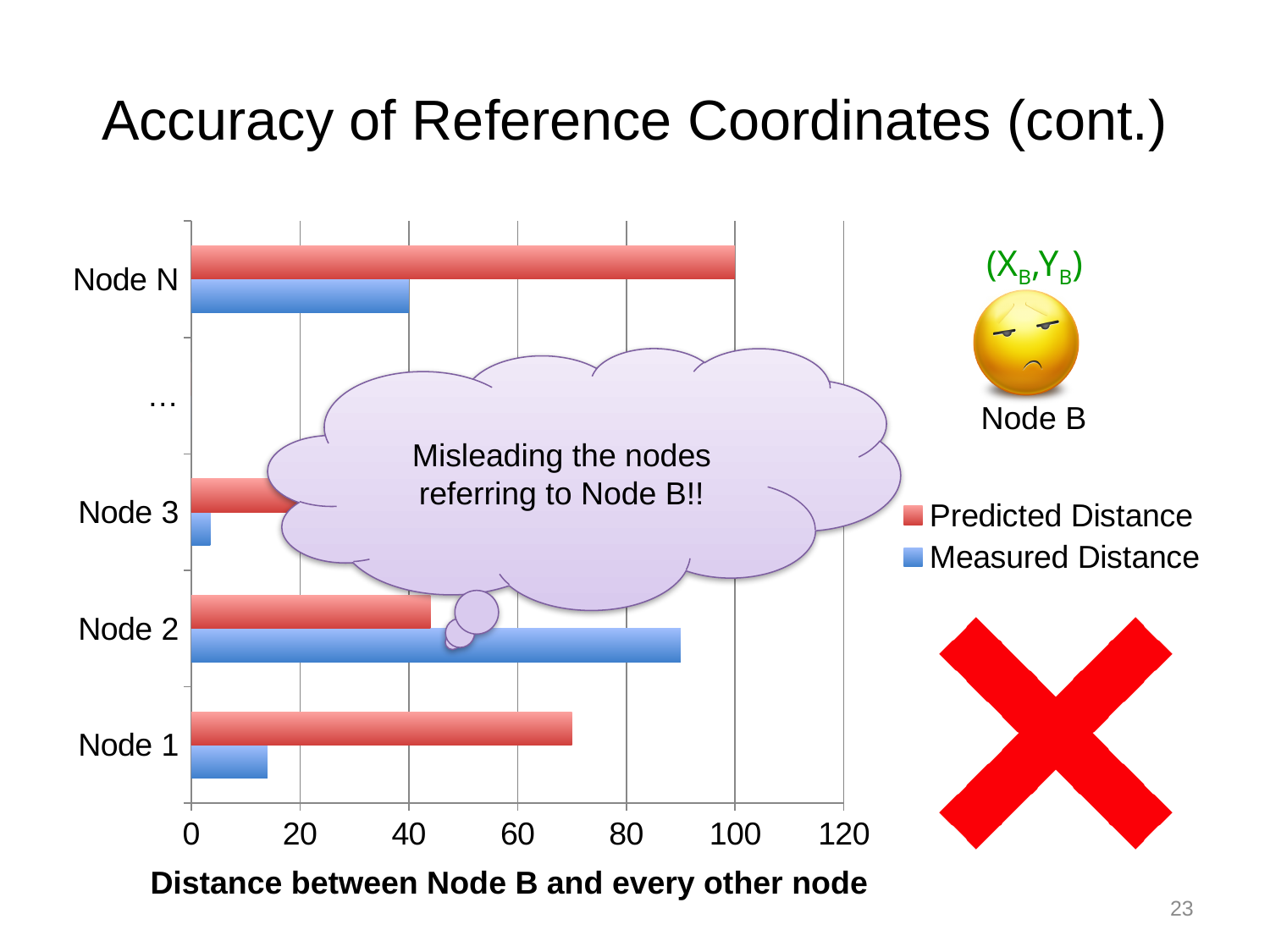
Is the Predicted Distance for Node 1 greater or less than 60? greater What is the title of the horizontal axis of the chart? Distance between Node B and every other node Which node has the lowest Measured Distance? Node 3 How many series does the chart legend list? 2 Is the Measured Distance for Node 1 greater or less than 20? less For Node 2, which is larger: the Predicted Distance or the Measured Distance? Measured Distance What is the Measured Distance for Node N? 40 What is the Predicted Distance for Node N? 100 Which node has the highest Predicted Distance? Node N Is the Measured Distance for Node 2 greater or less than 80? greater For Node 1, which is larger: the Predicted Distance or the Measured Distance? Predicted Distance What kind of chart is shown on the slide? bar chart